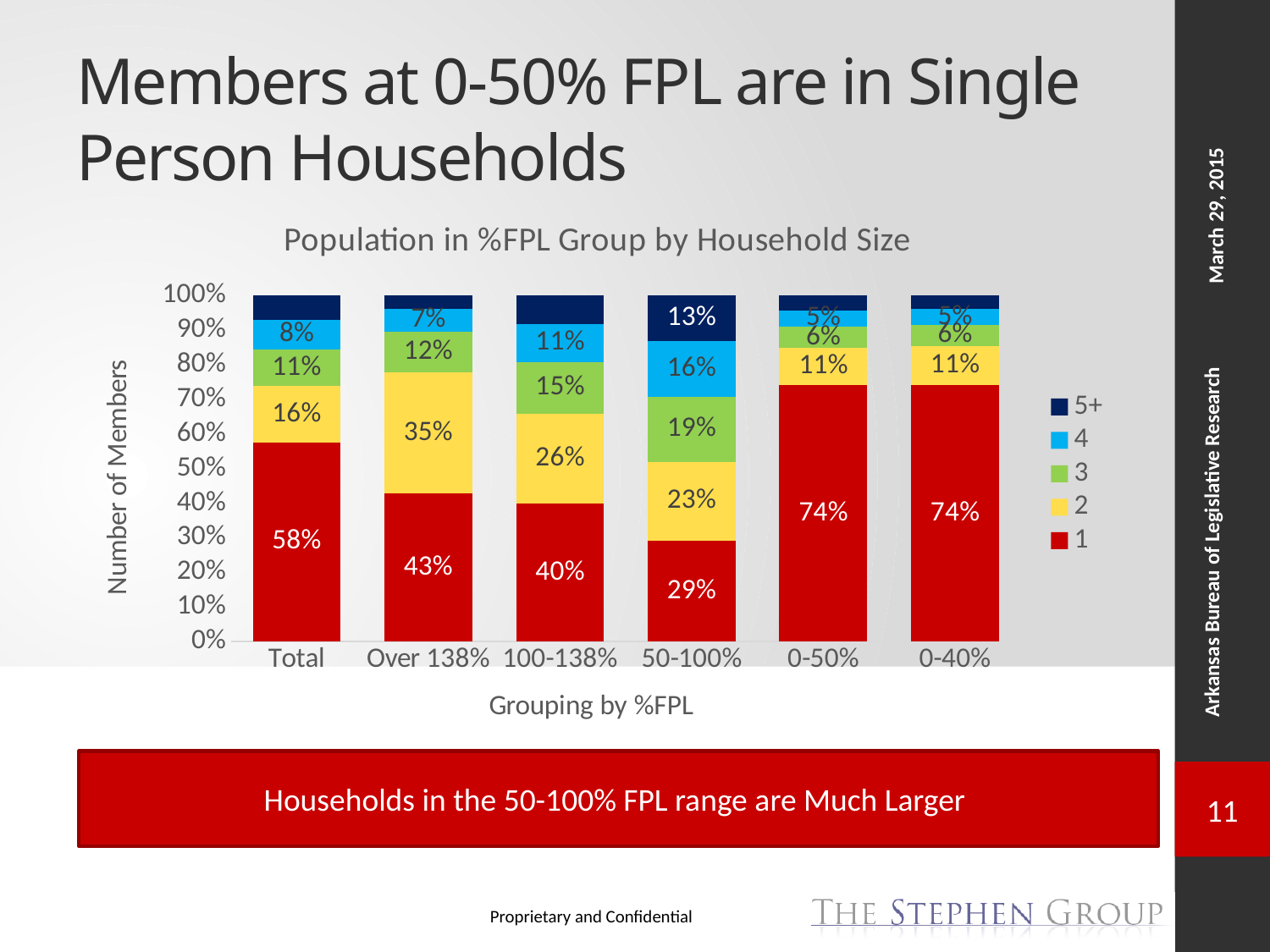
What is the value for household size 2 in the Over 138% group? 35% What is the title of the chart? Population in %FPL Group by Household Size Which %FPL group has the lowest value for household size 1? 50-100% Which %FPL group has the highest value for household size 2? Over 138% Which is larger: the household size 3 value for 100-138% or for 50-100%? 50-100% How many series does the legend list? 5 What is the value for household size 5+ in the 50-100% group? 13% How many %FPL groupings are shown on the x axis? 6 What type of chart is shown on the slide? Stacked bar chart What is the difference between the household size 1 values for the 0-50% group and the 50-100% group? 45% What is the value for household size 1 in the Total group? 58% What is the value for household size 1 in the 0-50% group? 74%